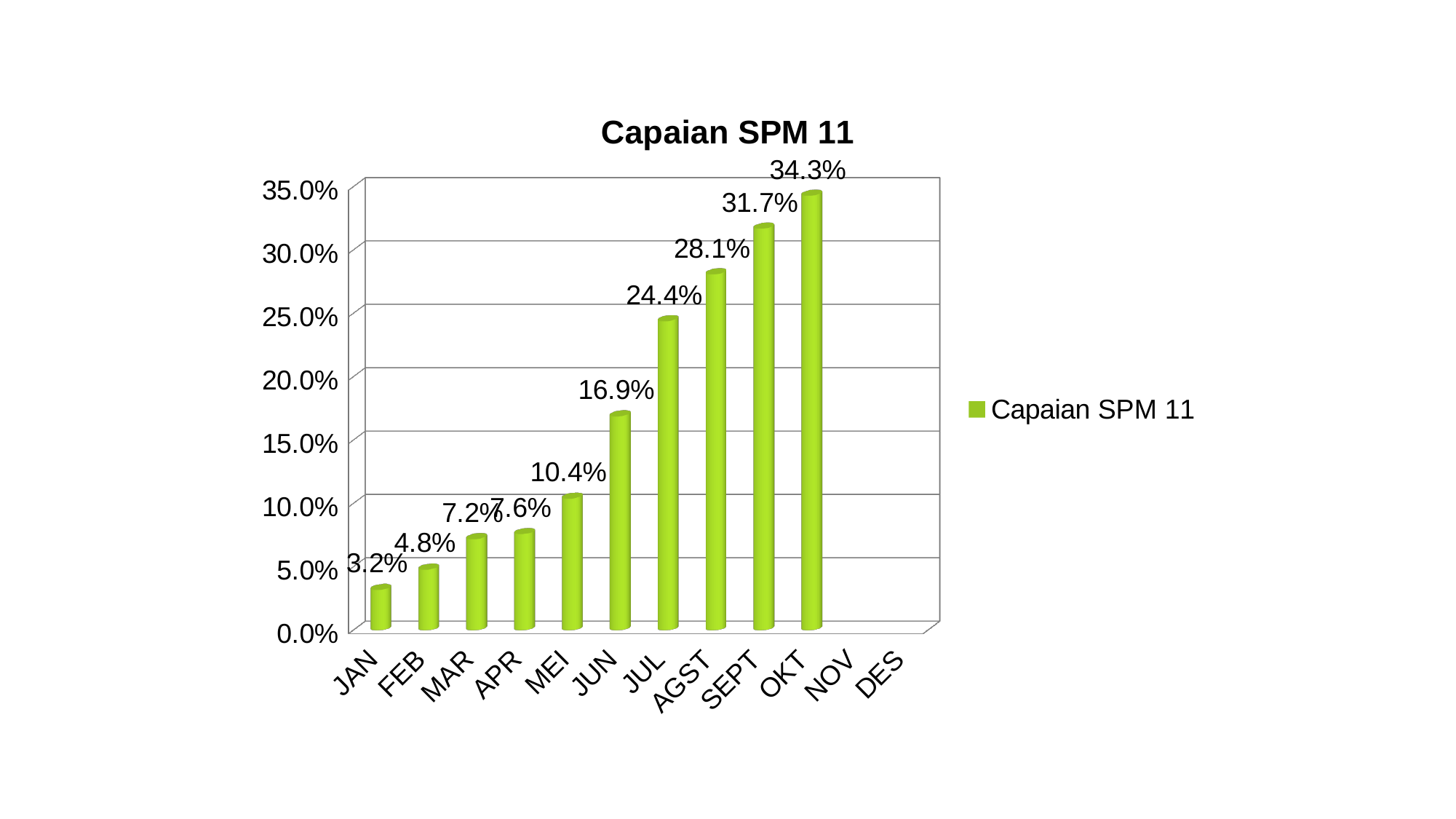
Do the values rise or fall from JAN to OKT? rise What kind of chart is shown? bar chart What is the difference between the values for JUL and JUN? 7.5% Which month has the lowest value among the months with bars? JAN What is the value for JUN? 16.9% Is the value for JUL greater or less than 20.0%? greater Which is larger, the value for AGST or the value for JUL? AGST What is the value for SEPT? 31.7% What is the value for MEI? 10.4% How many months are listed on the x axis? 12 What is the difference between the values for OKT and SEPT? 2.6% Which month has the highest value? OKT